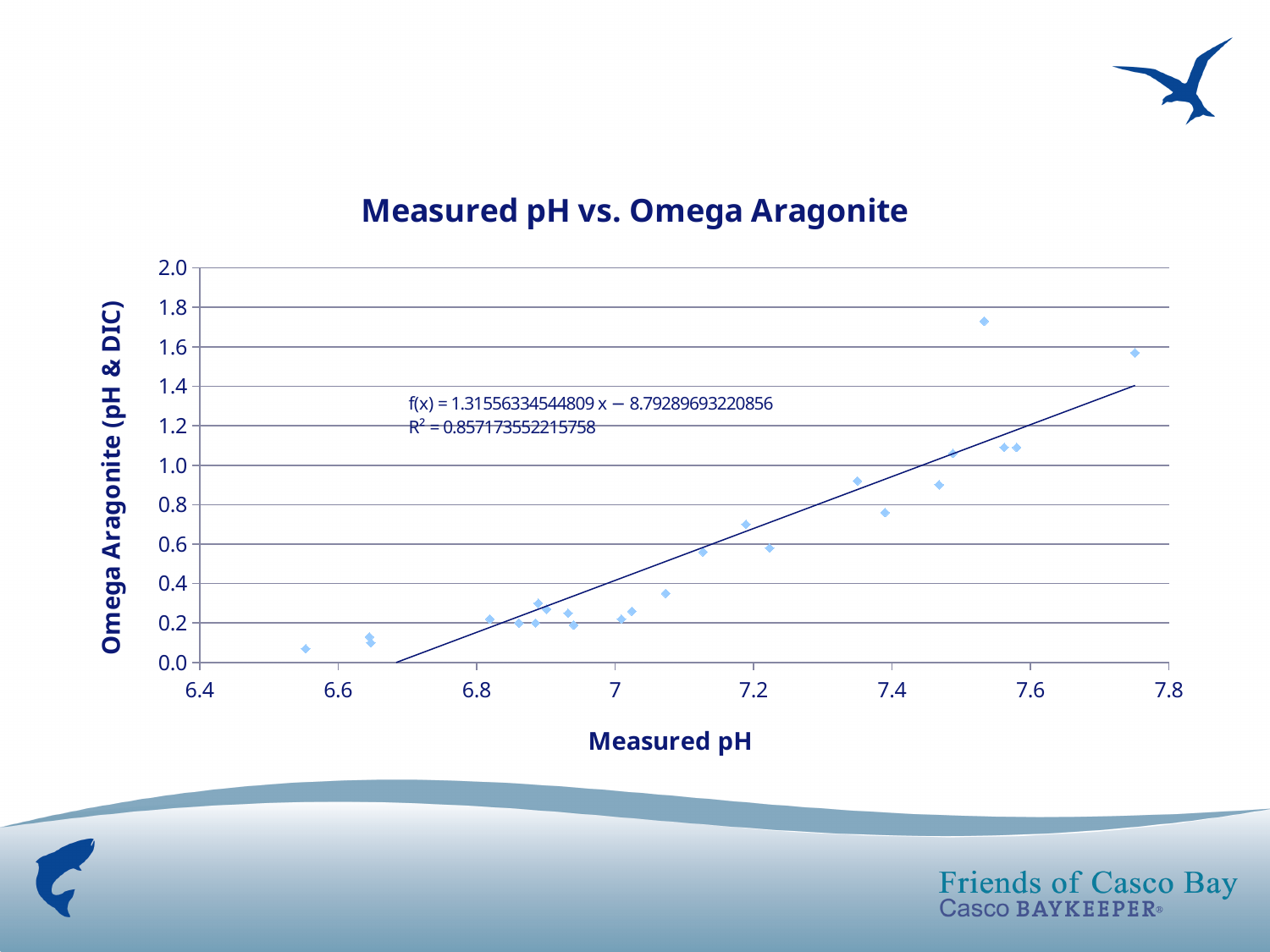
Is the Omega Aragonite value of the highest point on the chart greater or less than 1.6? greater What is the label of the vertical axis? Omega Aragonite (pH & DIC) Is the Omega Aragonite value of the point with the lowest Measured pH (near 6.55) greater or less than 0.2? less What is the constant term in the trendline equation printed on the chart? −8.79289693220856 Is the Omega Aragonite value of the point at the far right (Measured pH near 7.75) greater or less than 1.4? greater What kind of chart is shown on the slide? Scatter chart What is the slope (coefficient of x) in the trendline equation printed on the chart? 1.31556334544809 What is the title of the chart? Measured pH vs. Omega Aragonite What is the maximum value shown on the horizontal axis? 7.8 As Measured pH increases along the x axis, do the Omega Aragonite values generally rise or fall? Rise What R² value is printed on the chart for the trendline? 0.857173552215758 What is the maximum value shown on the vertical axis? 2.0